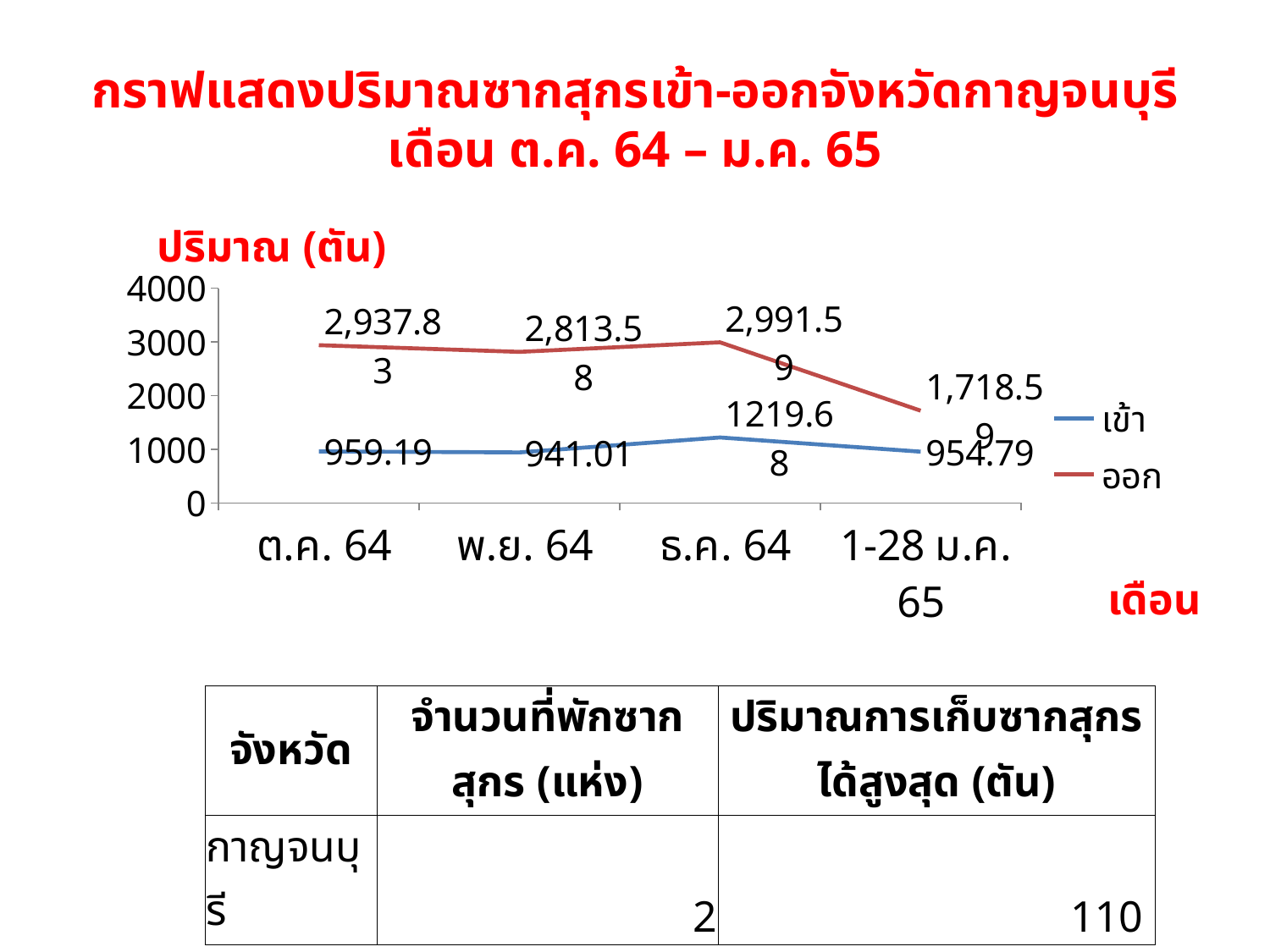
In which month is the ออก series highest? ธ.ค. 64 What is the value of the เข้า series for พ.ย. 64? 941.01 What is the value of the ออก series for 1-28 ม.ค. 65? 1,718.59 What kind of chart is shown on the slide? line chart What is the value of the ออก series for ต.ค. 64? 2,937.83 Is the ออก value for 1-28 ม.ค. 65 greater or less than 2000? less In which month is the เข้า series lowest? พ.ย. 64 How many months (categories) are plotted along the x axis of the chart? 4 What is the value of the เข้า series for ธ.ค. 64? 1219.68 How many series does the chart legend list? 2 What is the label on the y axis of the chart? ปริมาณ (ตัน) Which is larger for ธ.ค. 64, the เข้า value or the ออก value? ออก